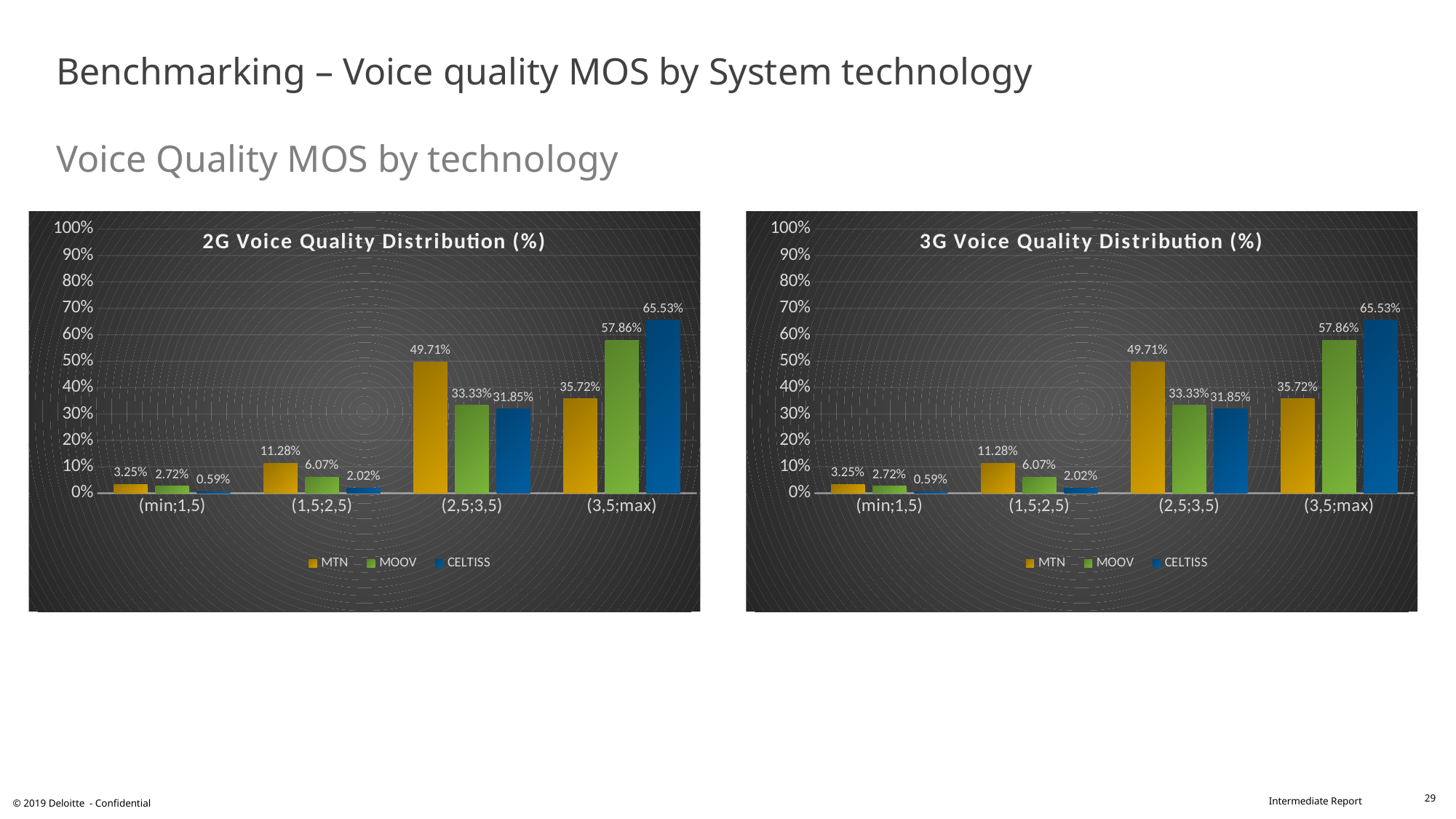
In the 3G Voice Quality Distribution (%) chart, which series has the lowest value in the (min;1,5) category? CELTISS In the 3G Voice Quality Distribution (%) chart, how many series does the legend list? 3 In the 3G Voice Quality Distribution (%) chart, which colour represents MTN? Gold/yellow In the 3G Voice Quality Distribution (%) chart, what is the value for CELTISS in the (min;1,5) category? 0.59% In the 2G Voice Quality Distribution (%) chart, what is the difference between MOOV and CELTISS in the (3,5;max) category? 7.67% In the 2G Voice Quality Distribution (%) chart, what is the value for MOOV in the (1,5;2,5) category? 6.07% In the 2G Voice Quality Distribution (%) chart, what is the value for MTN in the (2,5;3,5) category? 49.71% What kind of chart is the 2G Voice Quality Distribution (%) chart? Bar chart In the 2G Voice Quality Distribution (%) chart, which series has the highest value in the (3,5;max) category? CELTISS In the 2G Voice Quality Distribution (%) chart, how many categories are shown on the x axis? 4 In the 3G Voice Quality Distribution (%) chart, which is larger in the (2,5;3,5) category: MOOV or CELTISS? MOOV In the 3G Voice Quality Distribution (%) chart, what is the value for CELTISS in the (3,5;max) category? 65.53%